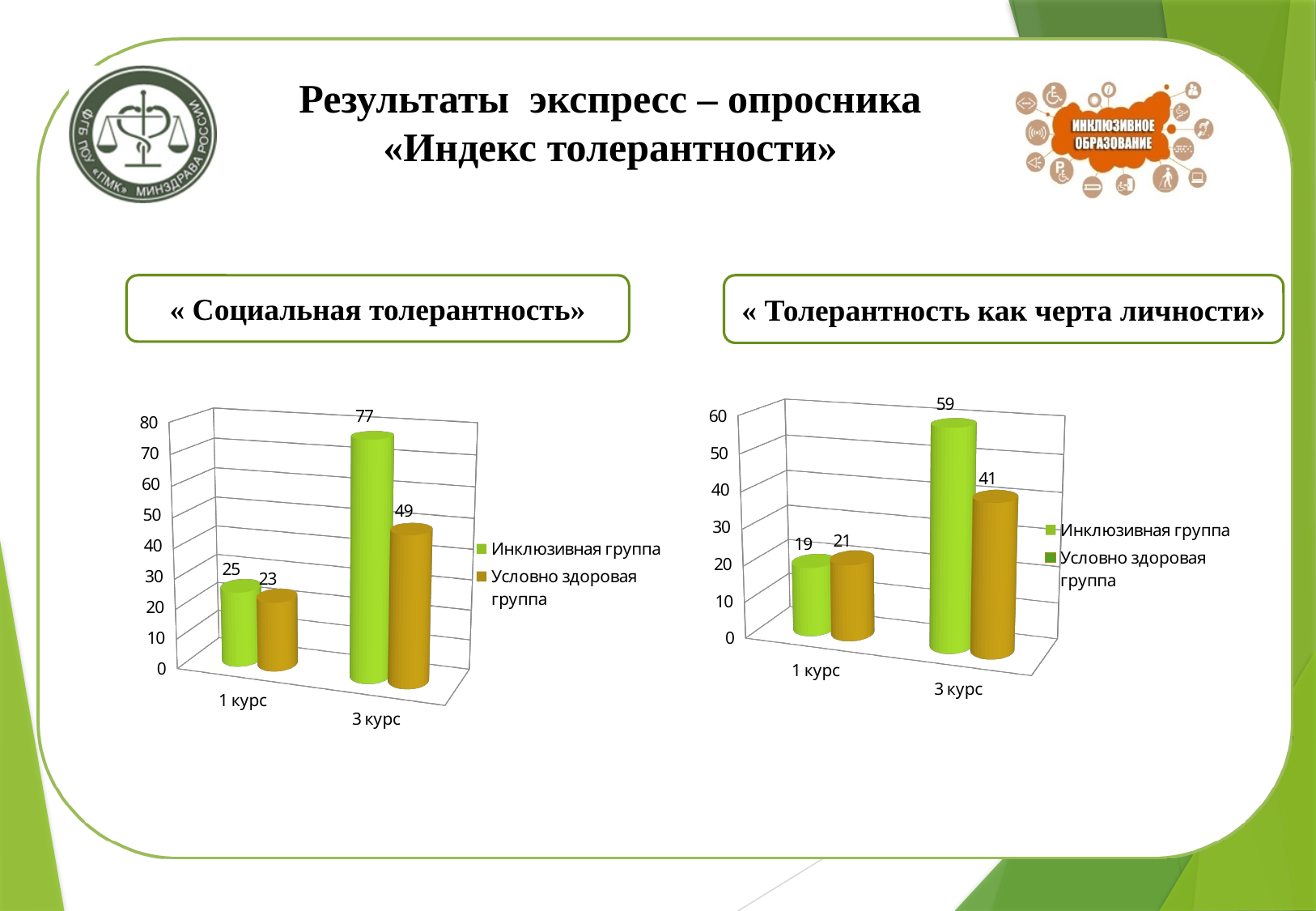
In the «Толерантность как черта личности» chart, what is the value for Условно здоровая группа at 1 курс? 21 In the «Социальная толерантность» chart, do the values for Инклюзивная группа rise or fall from 1 курс to 3 курс? Rise In the «Толерантность как черта личности» chart, what is the difference between Инклюзивная группа and Условно здоровая группа at 3 курс? 18 In the «Социальная толерантность» chart, what is the value for Условно здоровая группа at 1 курс? 23 In the «Толерантность как черта личности» chart, how many categories are shown on the x axis? 2 What kind of chart is the «Толерантность как черта личности» chart? Bar chart In the «Социальная толерантность» chart, what is the difference between Инклюзивная группа and Условно здоровая группа at 3 курс? 28 In the «Социальная толерантность» chart, which series has the higher value at 1 курс? Инклюзивная группа In the «Социальная толерантность» chart, how many series does the legend list? 2 In the «Толерантность как черта личности» chart, what is the value for Инклюзивная группа at 3 курс? 59 In the «Социальная толерантность» chart, what is the value for Инклюзивная группа at 3 курс? 77 In the «Толерантность как черта личности» chart, which series has the higher value at 1 курс? Условно здоровая группа